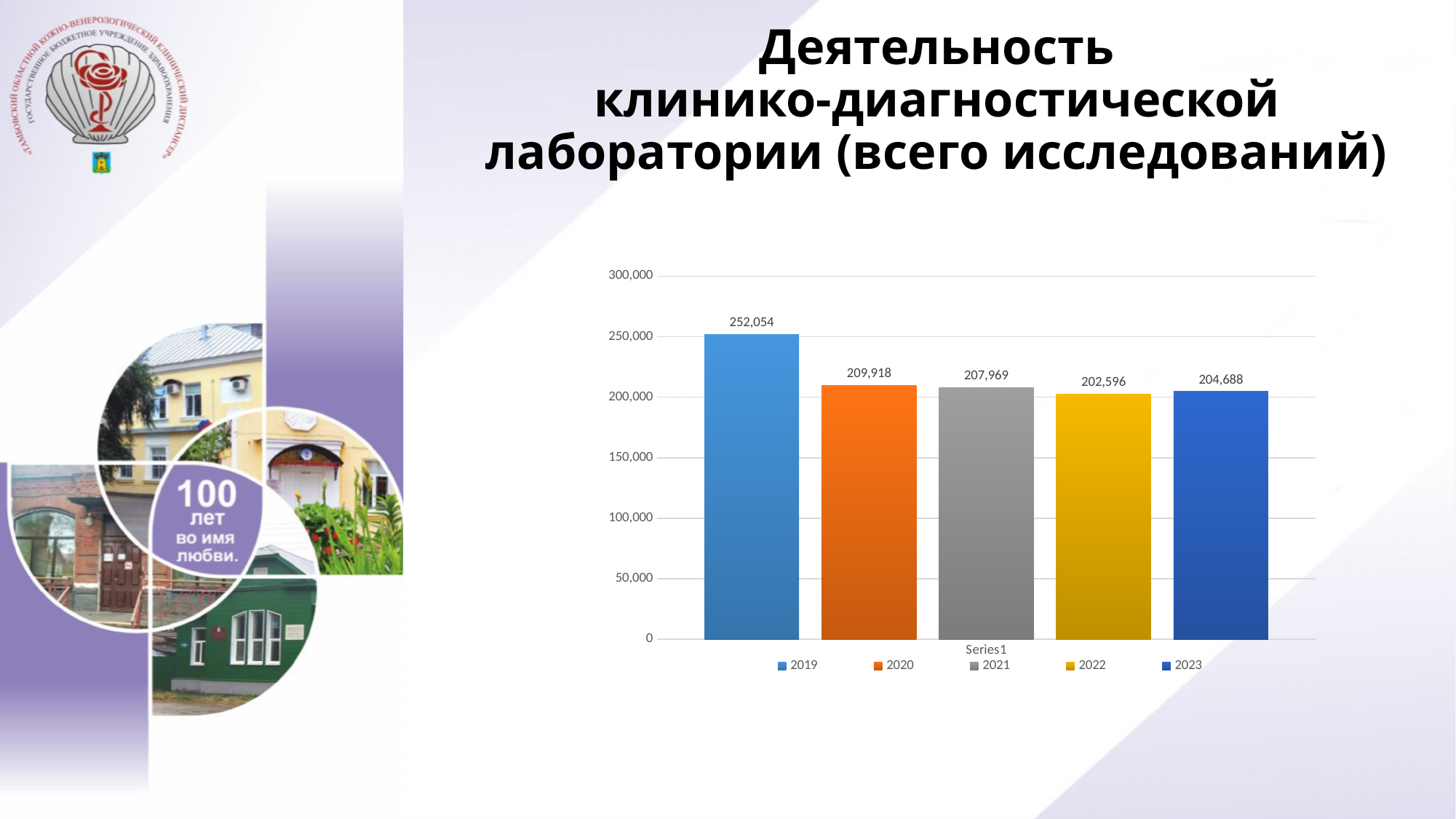
How many bars are plotted in the chart? 5 Is the value for 2022 greater or less than 250,000? less How many entries does the legend list? 5 What type of chart is shown on the slide? bar chart What is the difference between the values for 2019 and 2020? 42,136 What is the difference between the values for 2023 and 2022? 2,092 Which year has the highest value? 2019 What is the value for 2021? 207,969 Which year has the lowest value? 2022 What is the value for 2023? 204,688 Which is larger, the value for 2020 or the value for 2021? 2020 What is the value for 2019? 252,054